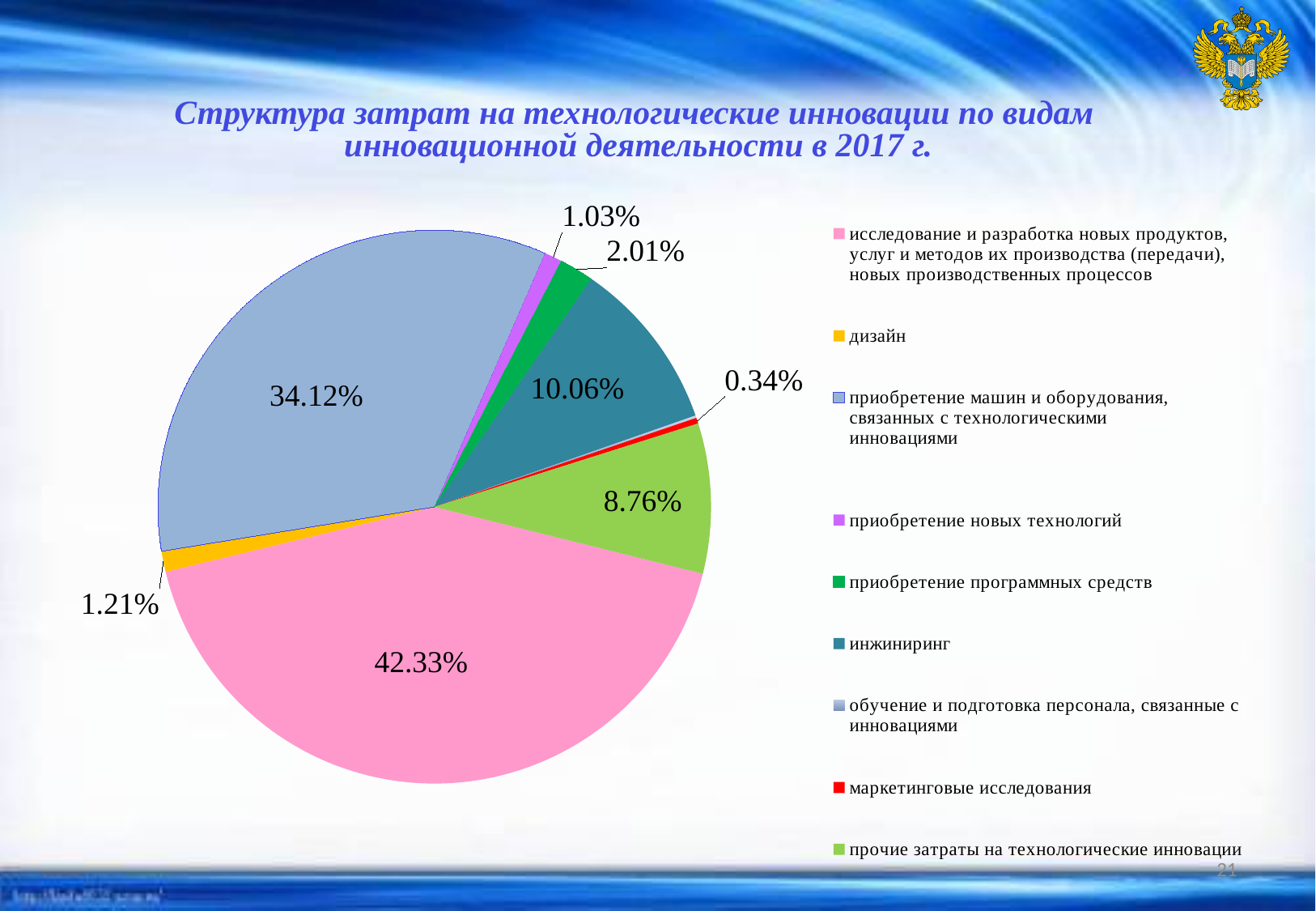
What share of the pie does 'приобретение машин и оборудования, связанных с технологическими инновациями' have? 34.12% What is the value shown for 'инжиниринг'? 10.06% What is the value shown for 'приобретение программных средств'? 2.01% What is the value shown for 'прочие затраты на технологические инновации'? 8.76% Which is larger: the slice for 'инжиниринг' or the slice for 'прочие затраты на технологические инновации'? инжиниринг What kind of chart is shown on the slide? pie chart What share of the pie does 'исследование и разработка новых продуктов, услуг и методов их производства (передачи), новых производственных процессов' have? 42.33% How many entries does the legend list? 9 Which category has the largest slice of the pie? исследование и разработка новых продуктов, услуг и методов их производства (передачи), новых производственных процессов What is the difference in percentage points between the largest slice (42.33%) and the 'приобретение машин и оборудования' slice (34.12%)? 8.21 What is the value shown for 'дизайн'? 1.21% What is the value shown for 'маркетинговые исследования'? 0.34%